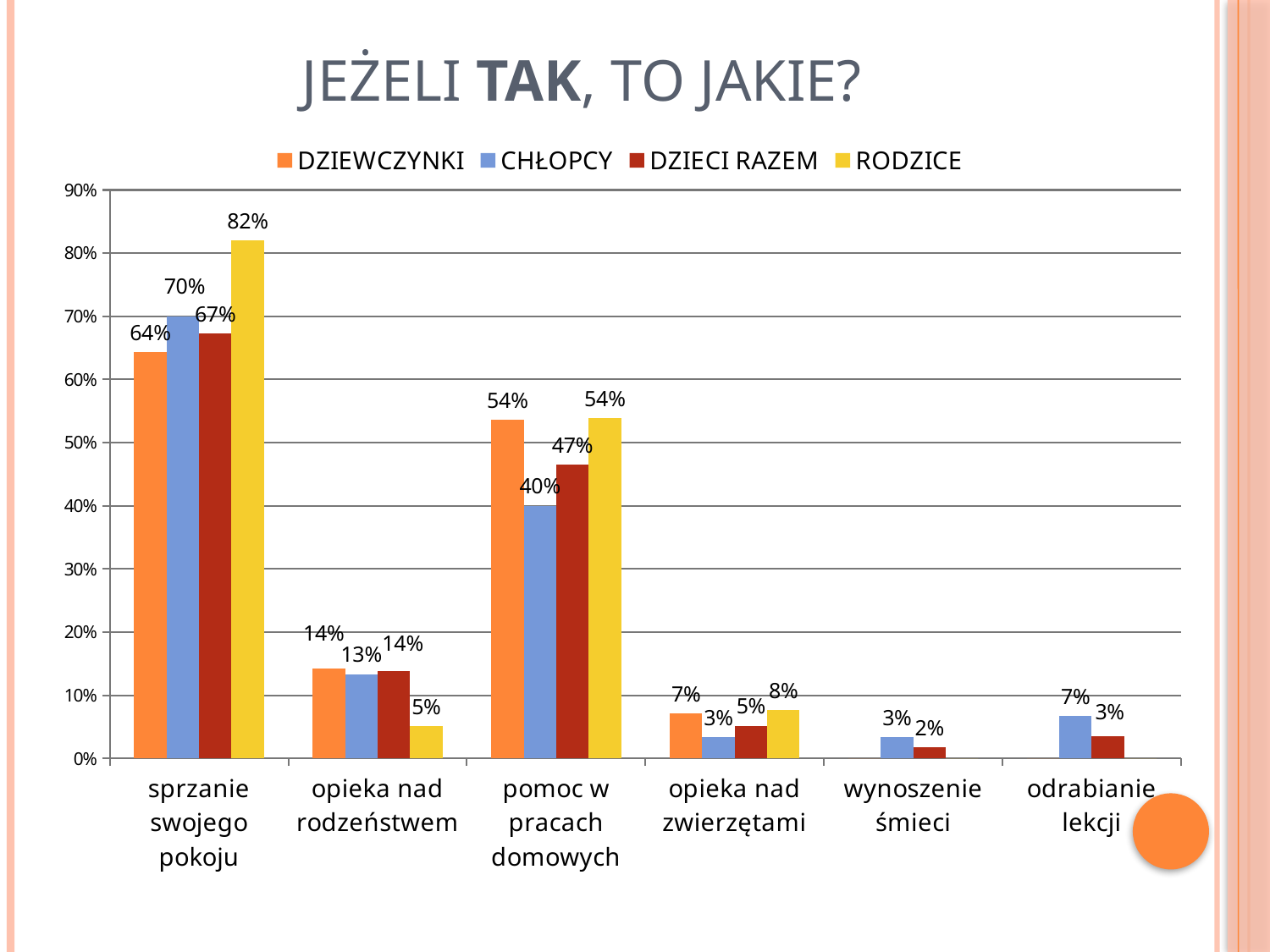
What is the title of the chart on the slide? JEŻELI TAK, TO JAKIE? What is the value for RODZICE in the category 'sprzanie swojego pokoju'? 82% How many categories are shown on the x axis? 6 What is the value for DZIECI RAZEM in the category 'opieka nad zwierzętami'? 5% Is the value for CHŁOPCY in 'sprzanie swojego pokoju' greater or less than 60%? greater How many series does the legend list? 4 What is the value for CHŁOPCY in the category 'pomoc w pracach domowych'? 40% Which is larger for 'pomoc w pracach domowych': the DZIEWCZYNKI value or the CHŁOPCY value? DZIEWCZYNKI What type of chart is shown on the slide? bar chart Which category has the highest value for the DZIEWCZYNKI series? sprzanie swojego pokoju What is the difference between the RODZICE and DZIEWCZYNKI values for 'sprzanie swojego pokoju'? 18%